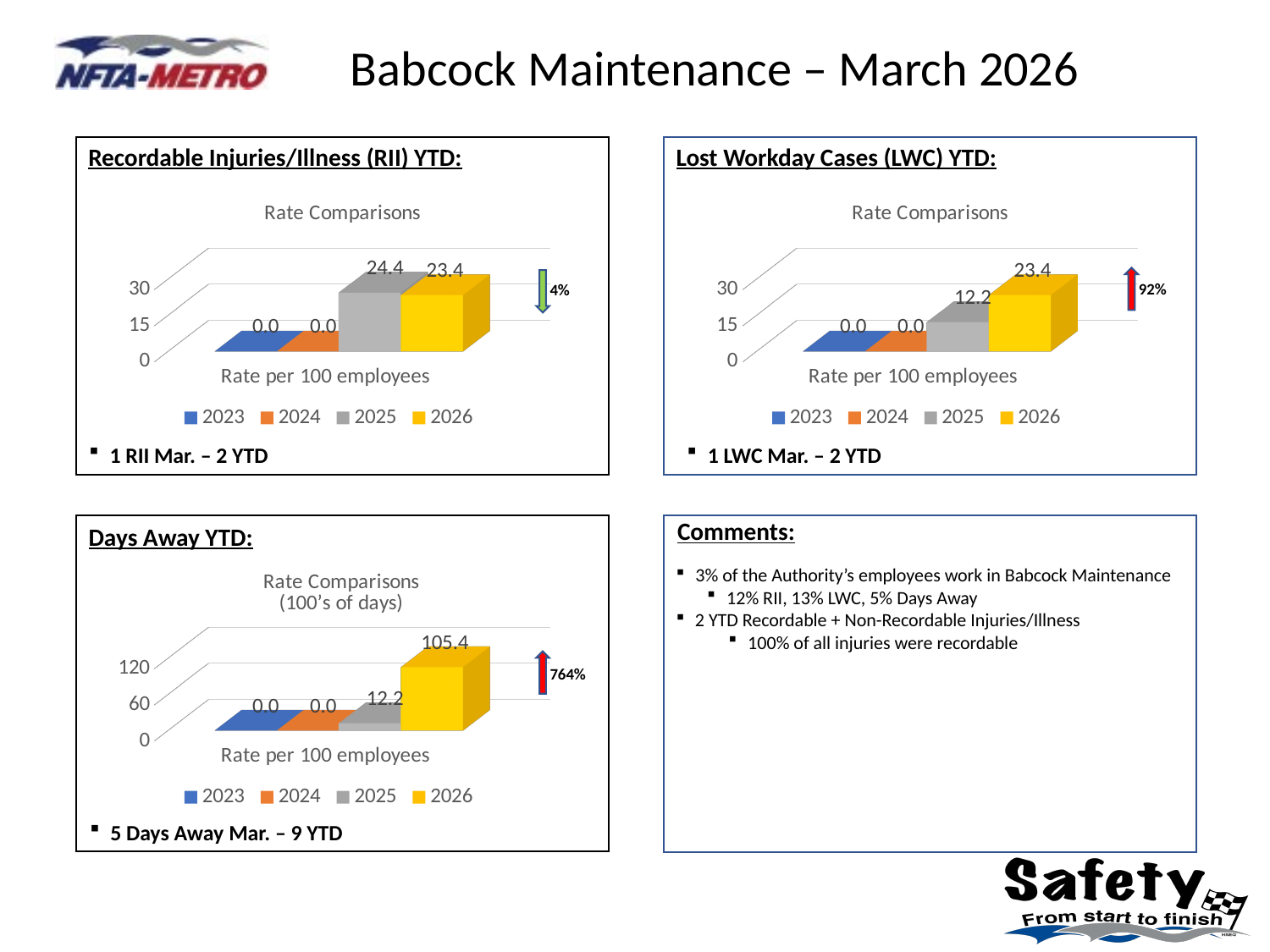
In the Days Away YTD chart, which is larger, the value for 2025 or the value for 2026? 2026 What kind of chart is the Recordable Injuries/Illness (RII) YTD chart? Bar chart In the Days Away YTD chart, is the value for 2026 greater or less than 60? greater In the Lost Workday Cases (LWC) YTD chart, which year has the highest value? 2026 In the Recordable Injuries/Illness (RII) YTD chart, what is the value for 2026? 23.4 In the Lost Workday Cases (LWC) YTD chart, what is the value for 2025? 12.2 In the Recordable Injuries/Illness (RII) YTD chart, what is the value for 2025? 24.4 What is the x-axis category label in the Lost Workday Cases (LWC) YTD chart? Rate per 100 employees In the Days Away YTD chart, what is the value for 2026? 105.4 In the Recordable Injuries/Illness (RII) YTD chart, what is the difference between the 2025 and 2026 values? 1.0 In the Lost Workday Cases (LWC) YTD chart, what is the difference between the 2026 and 2025 values? 11.2 How many series does the legend list in the Days Away YTD chart? 4